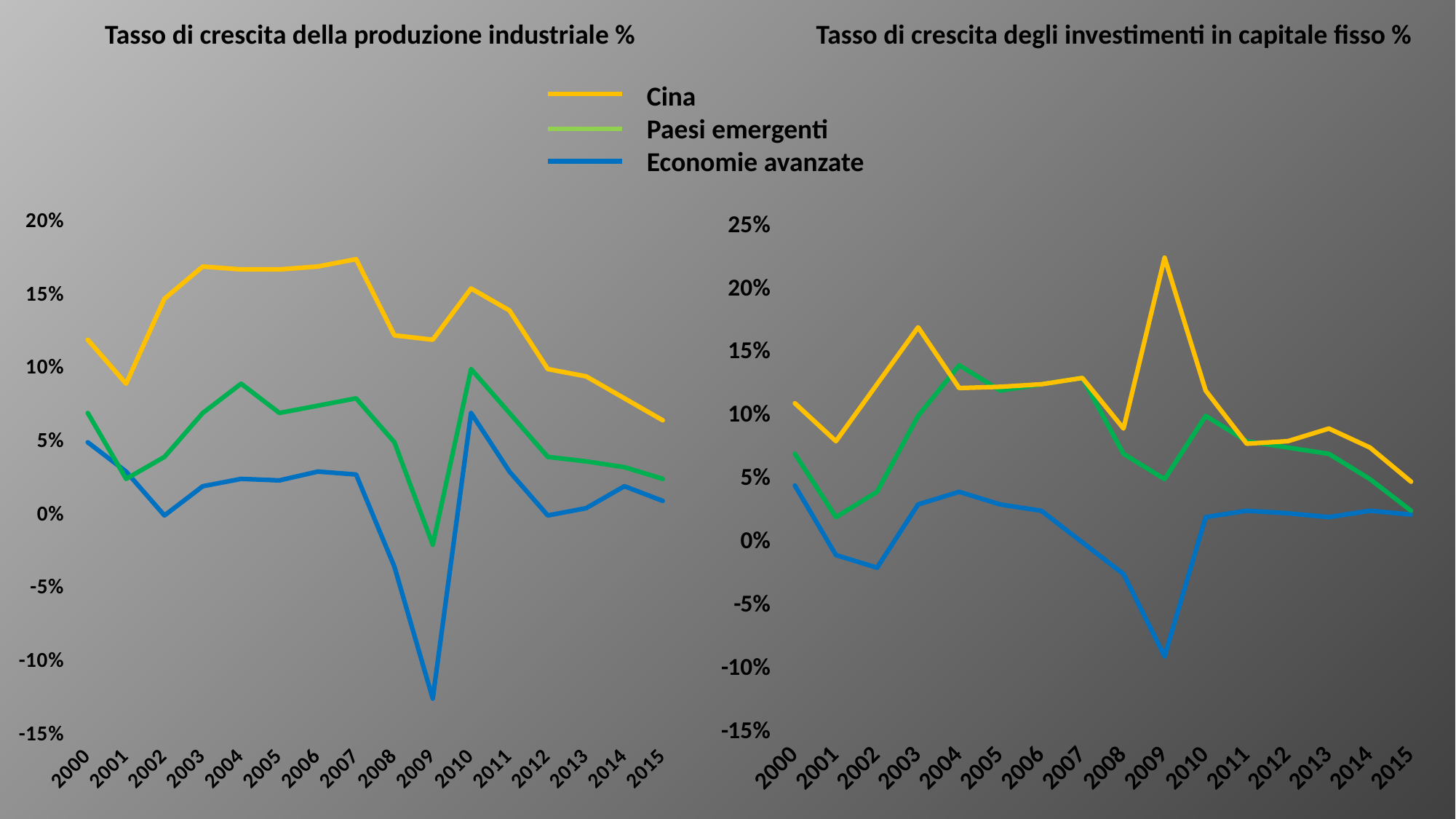
In the left chart, 'Tasso di crescita della produzione industriale %', in which year does the Cina line reach its highest value? 2007 In the right chart, 'Tasso di crescita degli investimenti in capitale fisso %', is the value for Economie avanzate in 2009 greater or less than -5%? less How many series does the legend list? 3 In the left chart, 'Tasso di crescita della produzione industriale %', which series has the larger value in 2009, Cina or Economie avanzate? Cina Which series is drawn in yellow in the charts? Cina What kind of chart is the left chart, 'Tasso di crescita della produzione industriale %'? line chart In the left chart, 'Tasso di crescita della produzione industriale %', in which year does the Economie avanzate line reach its lowest value? 2009 In the right chart, 'Tasso di crescita degli investimenti in capitale fisso %', how many years are shown on the x axis? 16 In the right chart, 'Tasso di crescita degli investimenti in capitale fisso %', is the value for Cina in 2009 greater or less than 20%? greater In the left chart, 'Tasso di crescita della produzione industriale %', does the Cina line rise or fall from 2010 to 2015? fall In the left chart, 'Tasso di crescita della produzione industriale %', is the value for Economie avanzate in 2009 greater or less than -10%? less In the right chart, 'Tasso di crescita degli investimenti in capitale fisso %', in which year does the Cina line reach its highest value? 2009